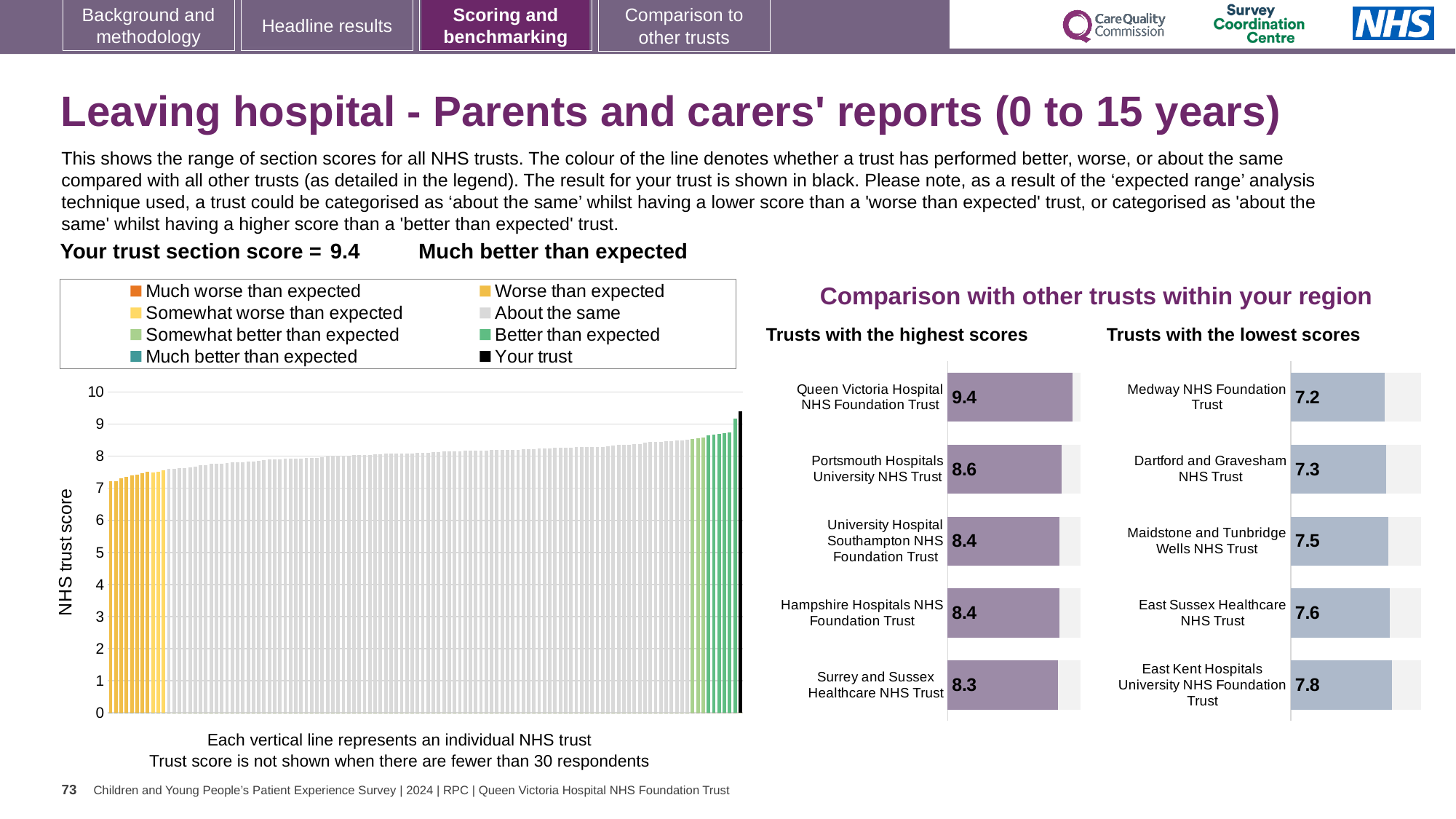
In the 'Trusts with the highest scores' chart, which trust has the lowest score? Surrey and Sussex Healthcare NHS Trust In the 'Trusts with the highest scores' chart, what is the score for Queen Victoria Hospital NHS Foundation Trust? 9.4 In the main NHS trust score chart on the left, do the values rise or fall from left to right? Rise How many entries does the legend of the main NHS trust score chart list? 8 How many trusts are shown in the 'Trusts with the lowest scores' chart? 5 In the 'Trusts with the lowest scores' chart, which trust has the highest score? East Kent Hospitals University NHS Foundation Trust In the main NHS trust score chart on the left, is the value for the black 'Your trust' bar greater or less than 9? greater In the 'Trusts with the highest scores' chart, what is the difference between the scores of Queen Victoria Hospital NHS Foundation Trust and Portsmouth Hospitals University NHS Trust? 0.8 In the 'Trusts with the lowest scores' chart, what is the score for Medway NHS Foundation Trust? 7.2 In the 'Trusts with the highest scores' chart, what is the score for Portsmouth Hospitals University NHS Trust? 8.6 What kind of chart is the main chart showing NHS trust scores on the left of the slide? Bar chart In the 'Trusts with the lowest scores' chart, which has the larger score: Dartford and Gravesham NHS Trust or Maidstone and Tunbridge Wells NHS Trust? Maidstone and Tunbridge Wells NHS Trust